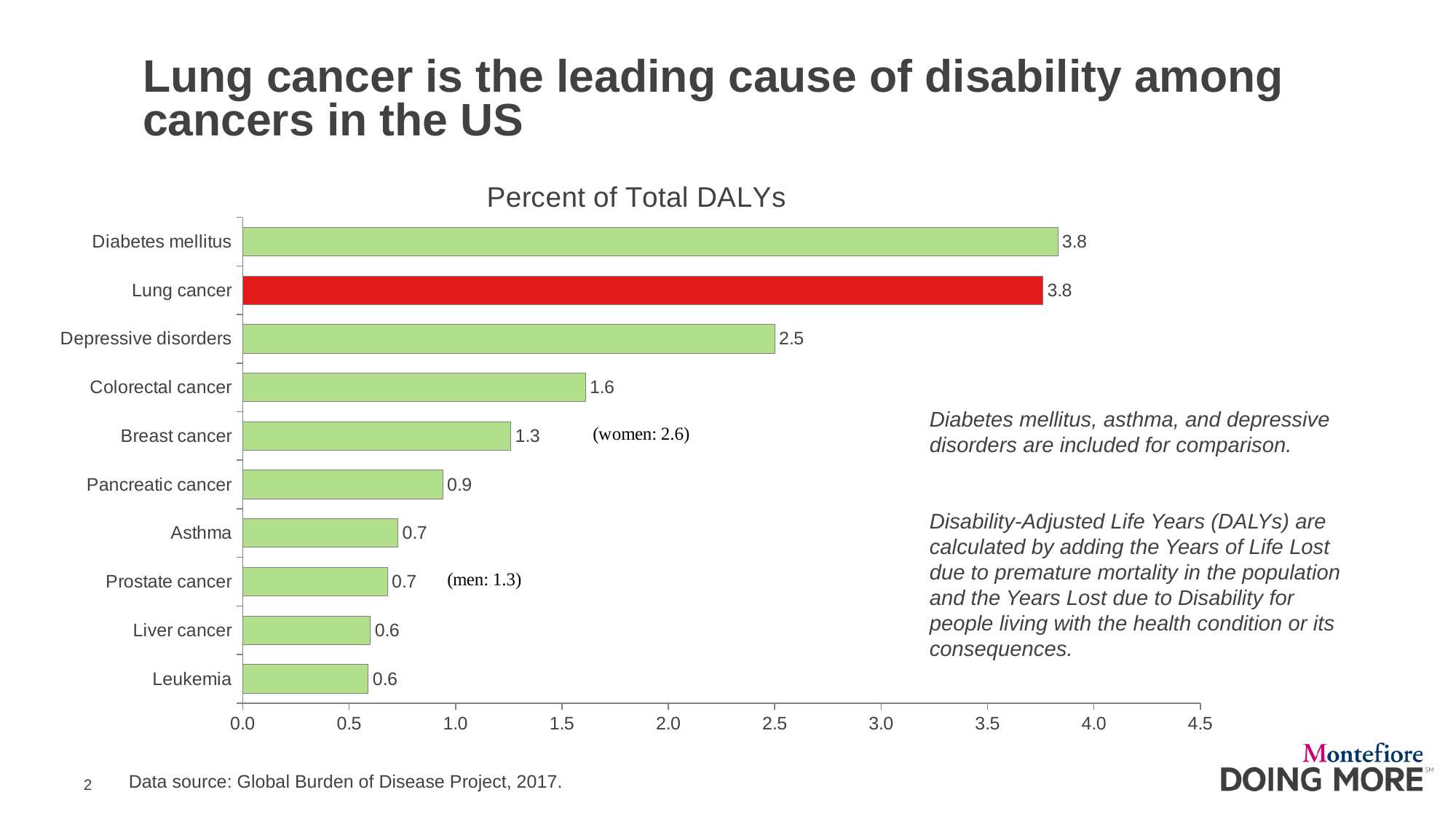
Which has a larger value, Colorectal cancer or Pancreatic cancer? Colorectal cancer What is the value for Pancreatic cancer? 0.9 What kind of chart is shown on the slide? Bar chart What is the difference between the values for Lung cancer and Breast cancer? 2.5 Is the value for Depressive disorders greater or less than 2.0? greater Which category's bar is coloured red? Lung cancer What is the value for Depressive disorders? 2.5 What is the value for Colorectal cancer? 1.6 What is the value for Lung cancer? 3.8 What is the value for Breast cancer? 1.3 What is the difference between the values for Depressive disorders and Colorectal cancer? 0.9 How many categories are shown in the chart? 10